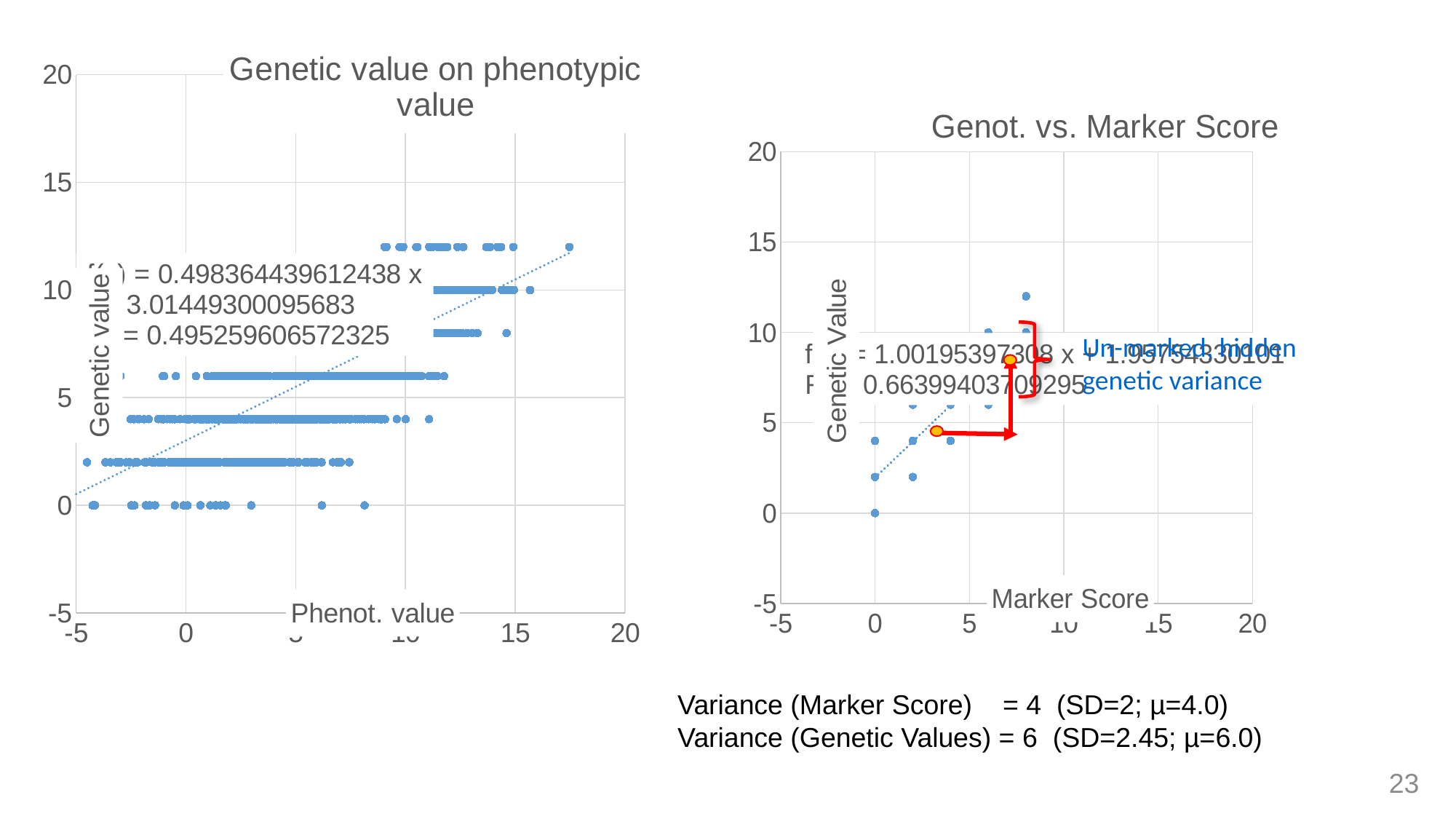
In the left chart, do genetic values generally rise or fall as phenotypic value increases along the x axis? Rise What is the x-axis label of the right chart? Marker Score What is the title of the right chart? Genot. vs. Marker Score In the right chart, do genetic values generally rise or fall as marker score increases along the x axis? Rise What kind of chart is the right chart titled "Genot. vs. Marker Score"? Scatter chart In the left chart, is the lowest plotted genetic value greater or less than 5? less In the right chart, is the highest plotted genetic value greater or less than 10? greater In the right chart, is the lowest plotted genetic value greater or less than 5? less What is the maximum value shown on the y axis of the left chart? 20 What is the minimum value shown on the x axis of the right chart? -5 What kind of chart is the left chart titled "Genetic value on phenotypic value"? Scatter chart